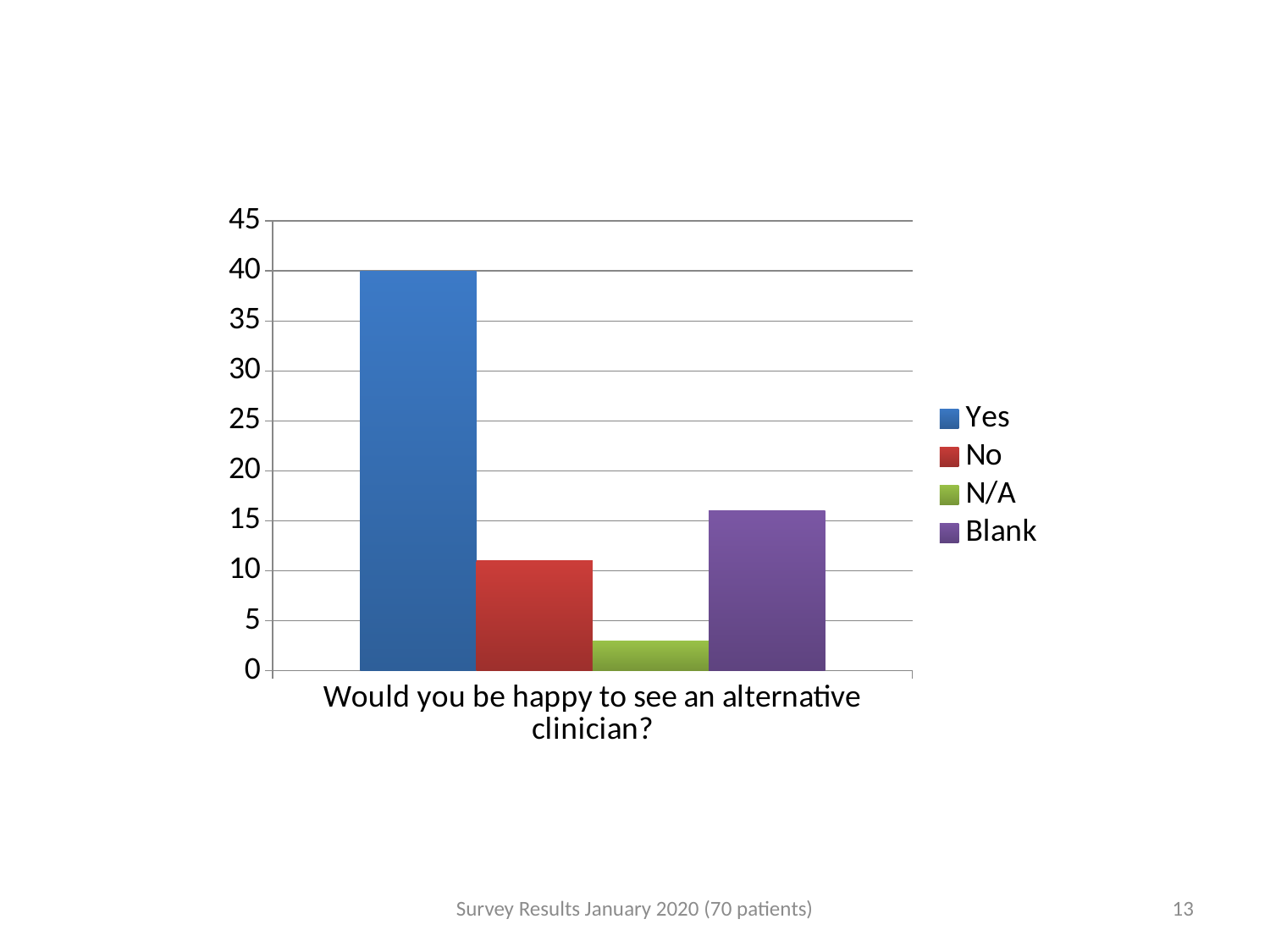
What question is shown as the category label on the x axis? Would you be happy to see an alternative clinician? What kind of chart is shown on the slide? bar chart What is the value for Yes? 40 Which is larger, the value for Yes or the value for No? Yes Is the value for No greater or less than 15? less Is the value for Blank greater or less than 15? greater Which series has the lowest value? N/A Which is larger, the value for No or the value for Blank? Blank Is the value for N/A greater or less than 5? less Which series has the highest value? Yes How many series does the legend list? 4 What colour is the bar for Blank? purple